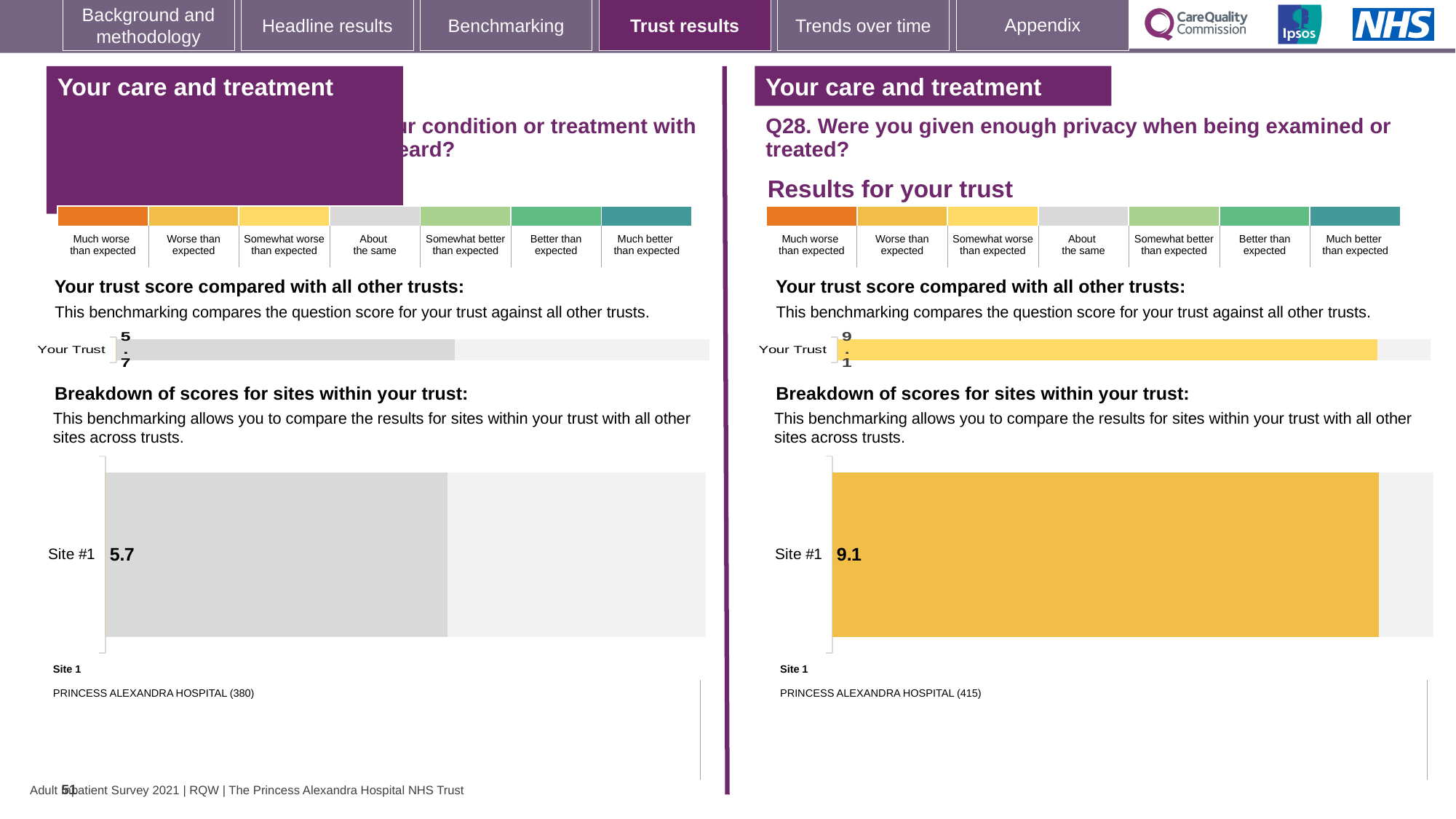
How many sites are shown in the left-hand 'Breakdown of scores for sites within your trust' chart? 1 In the right-hand 'Breakdown of scores for sites within your trust' chart (Q28), what is the score for Site #1? 9.1 On the right half of the slide (Q28), what is the score shown for Your Trust? 9.1 How many sites are shown in the right-hand 'Breakdown of scores for sites within your trust' chart? 1 What is the name of Site 1 listed under the right-hand (Q28) site breakdown chart? PRINCESS ALEXANDRA HOSPITAL (415) Which is larger: the Your Trust score on the left half of the slide or the Your Trust score on the right half (Q28)? Right half (Q28), 9.1 What type of chart is used to show the Site #1 score on the right half of the slide? Bar chart What is the difference between the Site #1 score for Q28 on the right and the Site #1 score on the left half of the slide? 3.4 Which benchmark category does the colour of the Your Trust bar on the left half of the slide correspond to? About the same In the left-hand 'Breakdown of scores for sites within your trust' chart, what is the score for Site #1? 5.7 Which benchmark category does the colour of the Q28 Your Trust bar on the right correspond to? Somewhat worse than expected On the left half of the slide, what is the score shown for Your Trust? 5.7